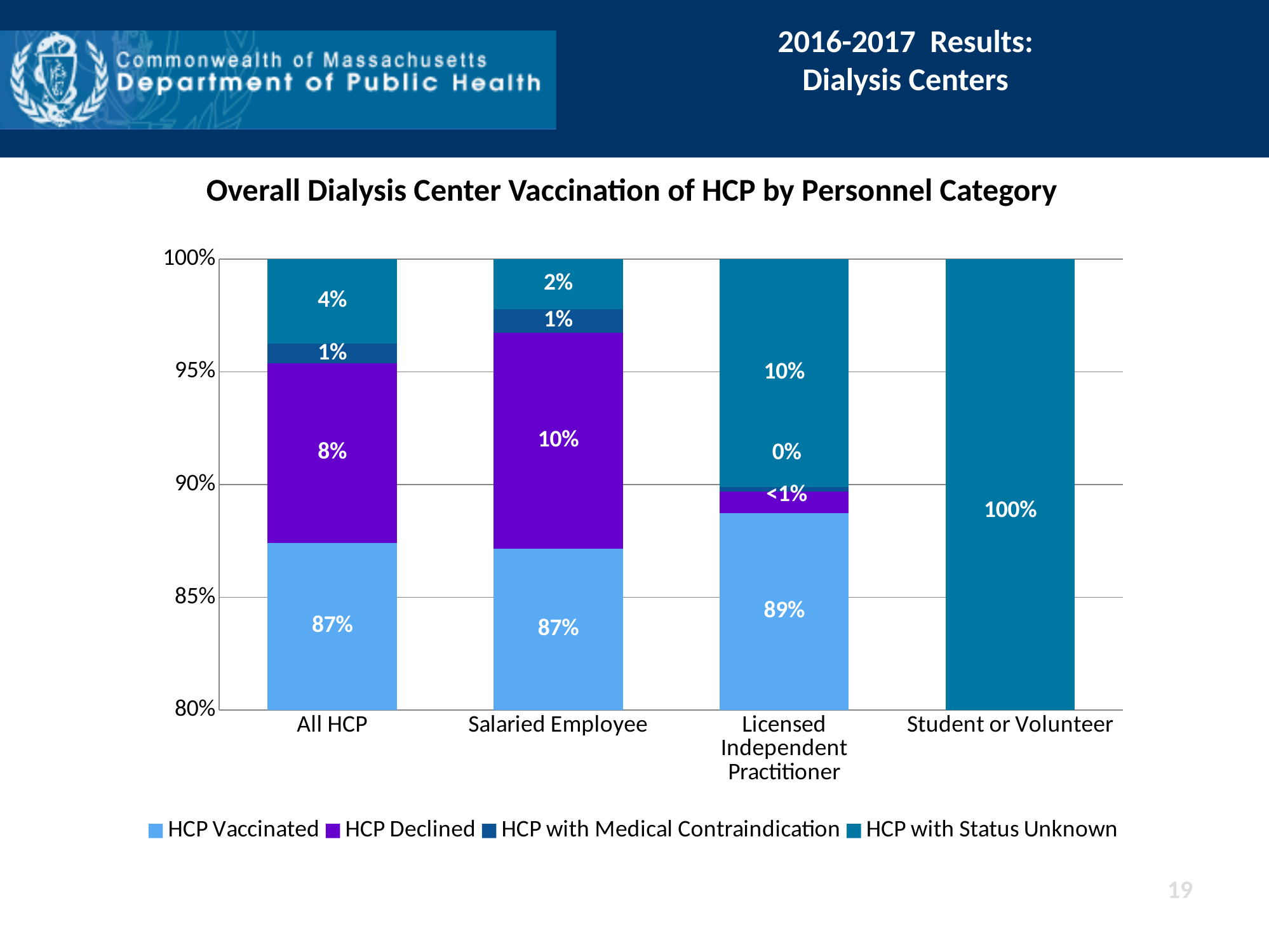
What percentage of Salaried Employees declined vaccination? 10% How many series does the legend list? 4 What percentage of All HCP were vaccinated? 87% What kind of chart is shown on the slide? Stacked bar chart How many personnel categories are shown on the x axis? 4 Which personnel category has the highest HCP Vaccinated percentage? Licensed Independent Practitioner Which personnel category has the lowest HCP with Status Unknown percentage? Salaried Employee What is the HCP Declined value for Licensed Independent Practitioner? <1% What is the HCP with Medical Contraindication value for All HCP? 1% Is the HCP Declined value larger for All HCP or for Salaried Employee? Salaried Employee What is the HCP with Status Unknown value for Licensed Independent Practitioner? 10% What is the HCP with Status Unknown value for Student or Volunteer? 100%